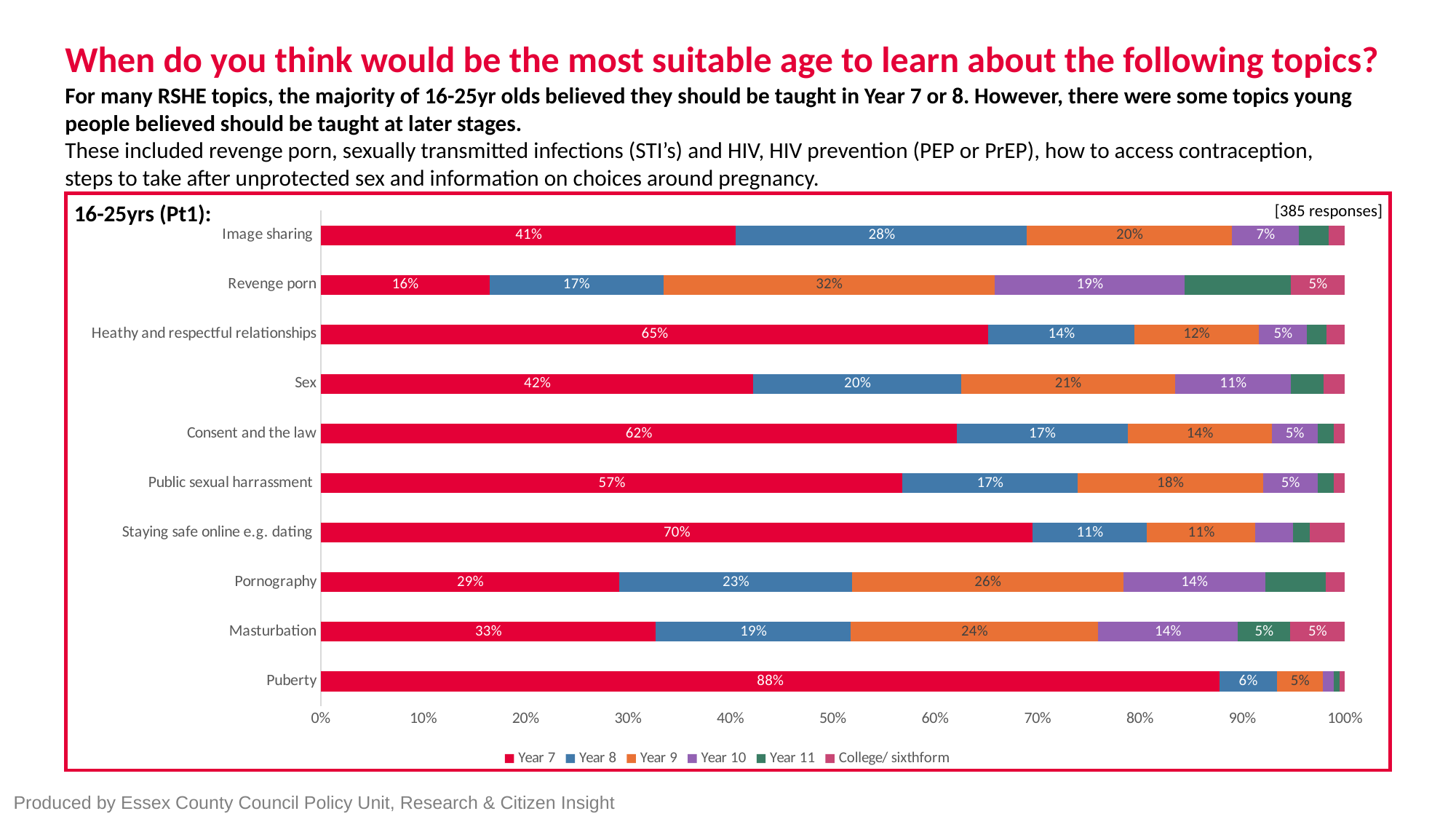
What is the difference between the Year 7 values for Staying safe online e.g. dating and Sex? 28 percentage points Which topic has the highest Year 7 percentage? Puberty How many series does the legend list? 6 How many topics are shown on the chart? 10 What is the Year 9 value for Revenge porn? 32% How many responses does the chart note in its top-right corner? 385 responses Which topic has the lowest Year 7 percentage? Revenge porn What percentage of 16-25 year olds said Puberty should be taught in Year 7? 88% Which has a larger Year 8 value: Image sharing or Sex? Image sharing What kind of chart is shown on the slide? Stacked bar chart What is the Year 8 value for Image sharing? 28% What is the Year 10 value for Pornography? 14%